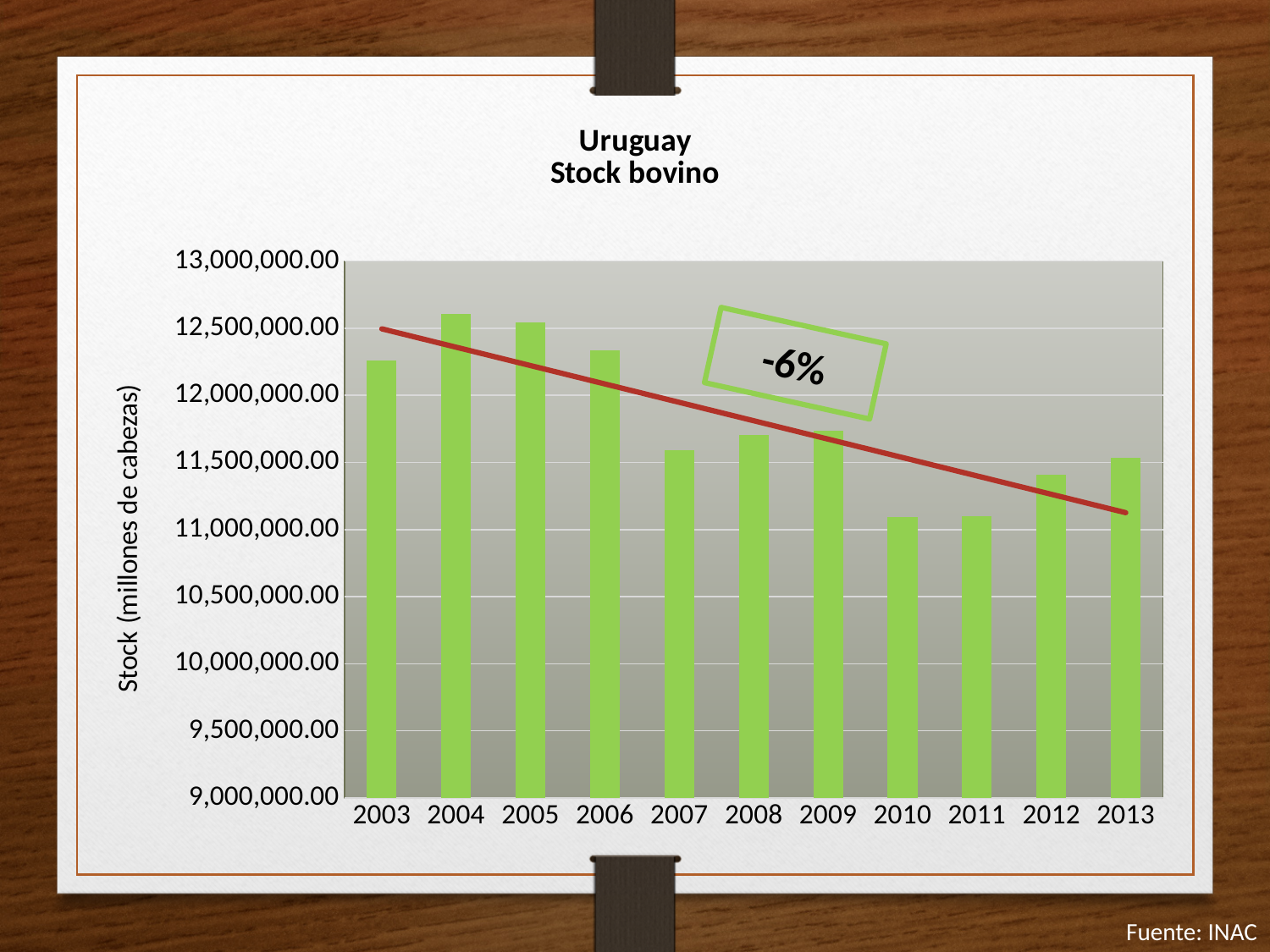
Overall, do the values rise or fall from 2003 to 2013? Fall Is the value for 2010 greater or less than 11,500,000.00? less Is the value for 2004 greater or less than 12,500,000.00? greater What percentage change is written in the annotation box on the chart? -6% Is the value for 2013 greater or less than 11,000,000.00? greater Which year has the larger value, 2006 or 2012? 2006 How many years are plotted on the x axis of the chart? 11 What is the title of the chart? Uruguay Stock bovino What kind of chart is shown on the slide? Bar chart Which year has the larger value, 2004 or 2010? 2004